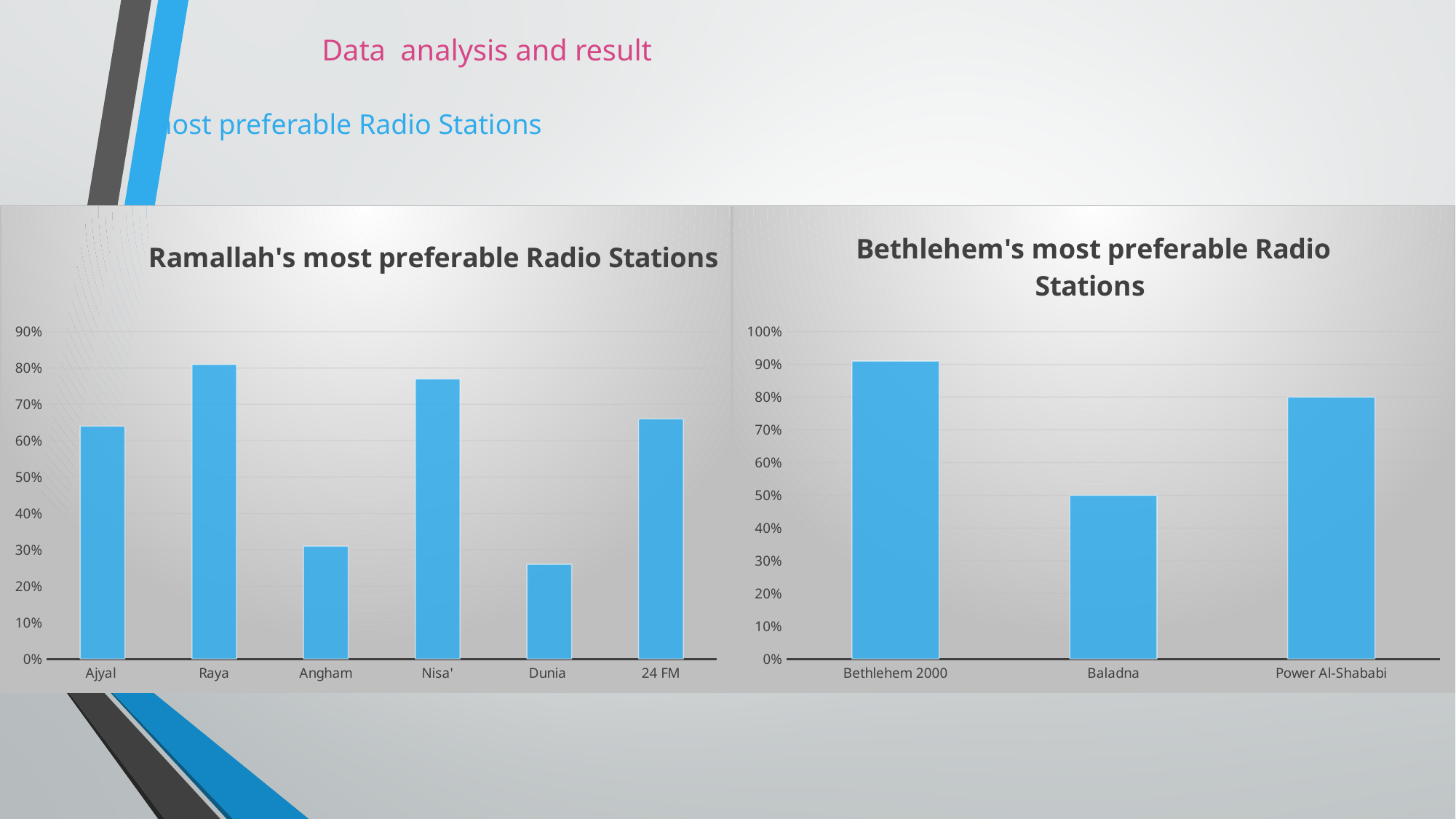
How many radio stations are shown in the "Bethlehem's most preferable Radio Stations" chart? 3 In the "Ramallah's most preferable Radio Stations" chart, which is larger, the value for Ajyal or the value for Angham? Ajyal In the "Bethlehem's most preferable Radio Stations" chart, which station has the lowest value? Baladna In the "Bethlehem's most preferable Radio Stations" chart, what is the value for Baladna? 50% In the "Bethlehem's most preferable Radio Stations" chart, which station has the highest value? Bethlehem 2000 In the "Ramallah's most preferable Radio Stations" chart, which station has the lowest value? Dunia How many radio stations are shown in the "Ramallah's most preferable Radio Stations" chart? 6 In the "Ramallah's most preferable Radio Stations" chart, which station has the highest value? Raya In the "Ramallah's most preferable Radio Stations" chart, is the value for Nisa' greater or less than 70%? greater In the "Ramallah's most preferable Radio Stations" chart, is the value for Angham greater or less than 40%? less What kind of chart is "Ramallah's most preferable Radio Stations"? bar chart In the "Bethlehem's most preferable Radio Stations" chart, is the value for Power Al-Shababi greater or less than 70%? greater